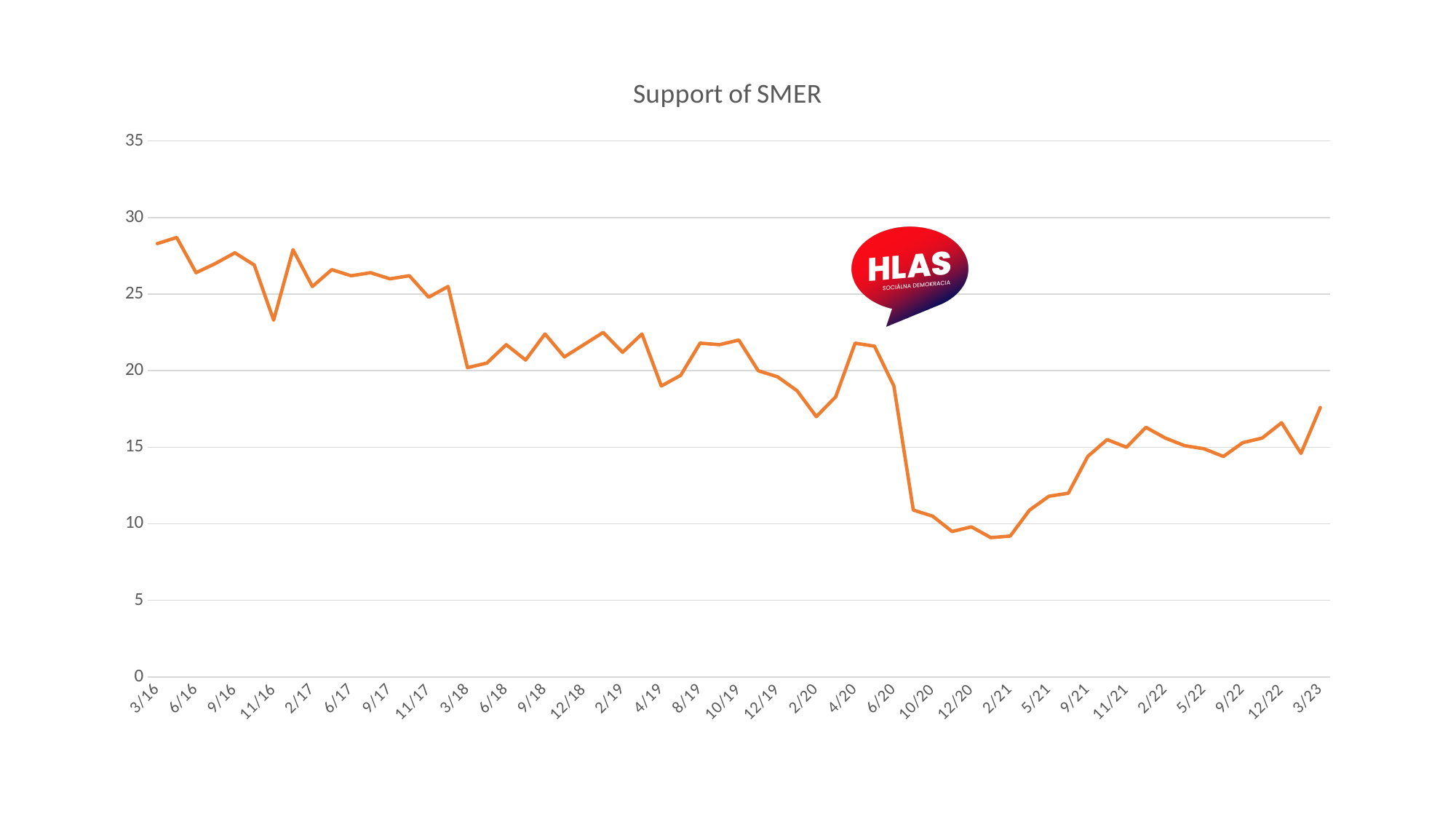
Is the value for 3/23 greater or less than 15? greater Is the value for 3/16 greater or less than 25? greater Is the value for 10/20 greater or less than 15? less What kind of chart is shown on the slide? line chart What colour is the line in the chart? orange Which is larger, the value for 2/21 or the value for 3/23? 3/23 Overall, does the support of SMER rise or fall from 3/16 to 3/23? fall What is the title of the chart? Support of SMER Which is larger, the value for 3/16 or the value for 3/23? 3/16